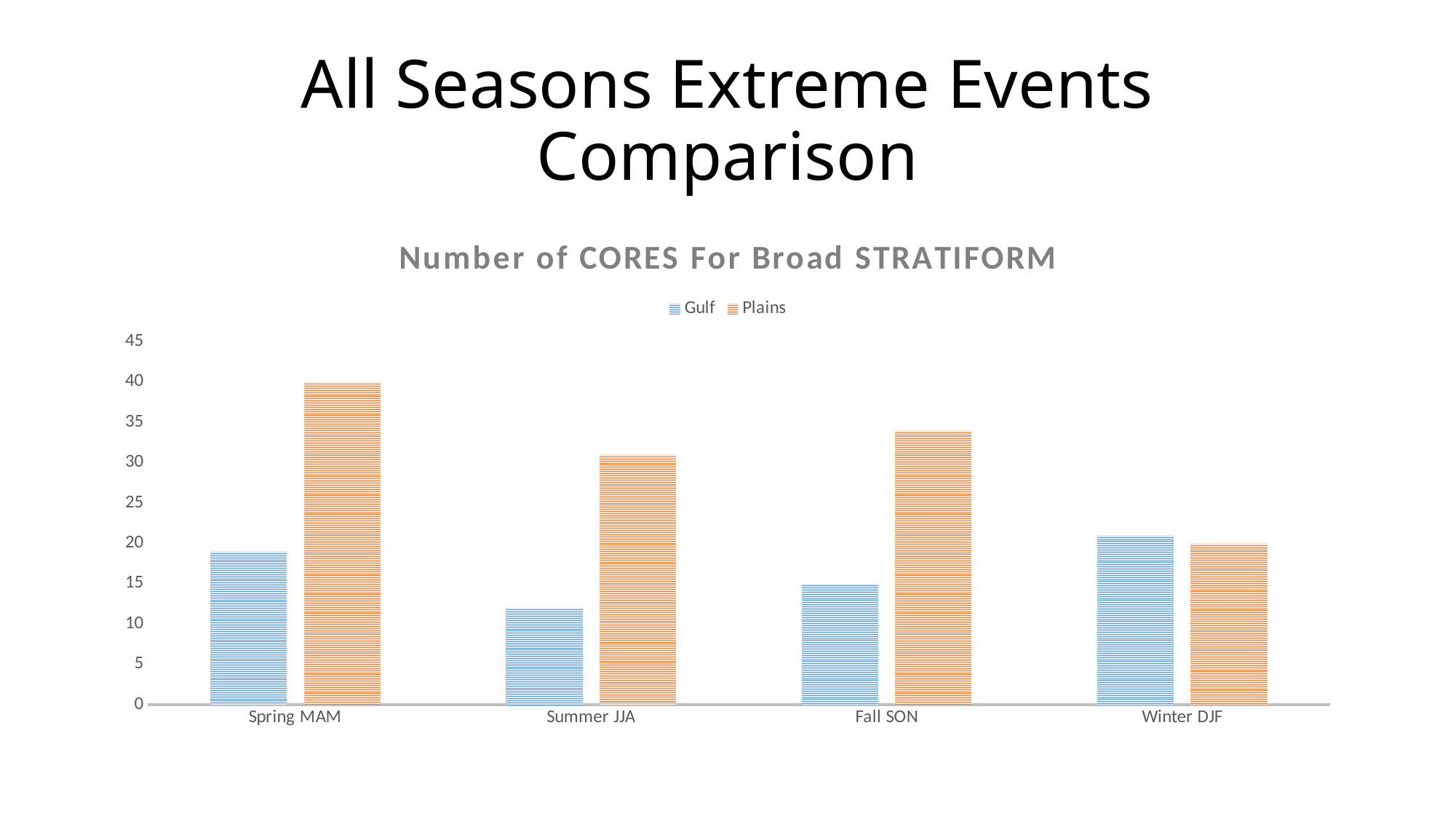
Is the Plains value for Fall SON greater or less than 30? greater Which is larger for Fall SON, the Gulf value or the Plains value? Plains Is the Gulf value for Summer JJA greater or less than 15? less What kind of chart is shown on the slide? bar chart Which is larger, the Gulf value for Winter DJF or the Gulf value for Summer JJA? Winter DJF Which season has the lowest Gulf value? Summer JJA How many series does the legend list? 2 What is the title of the chart? Number of CORES For Broad STRATIFORM Which season has the highest Plains value? Spring MAM Which season has the lowest Plains value? Winter DJF How many seasons (categories) are shown on the x axis? 4 Is the Plains value for Spring MAM greater or less than 35? greater